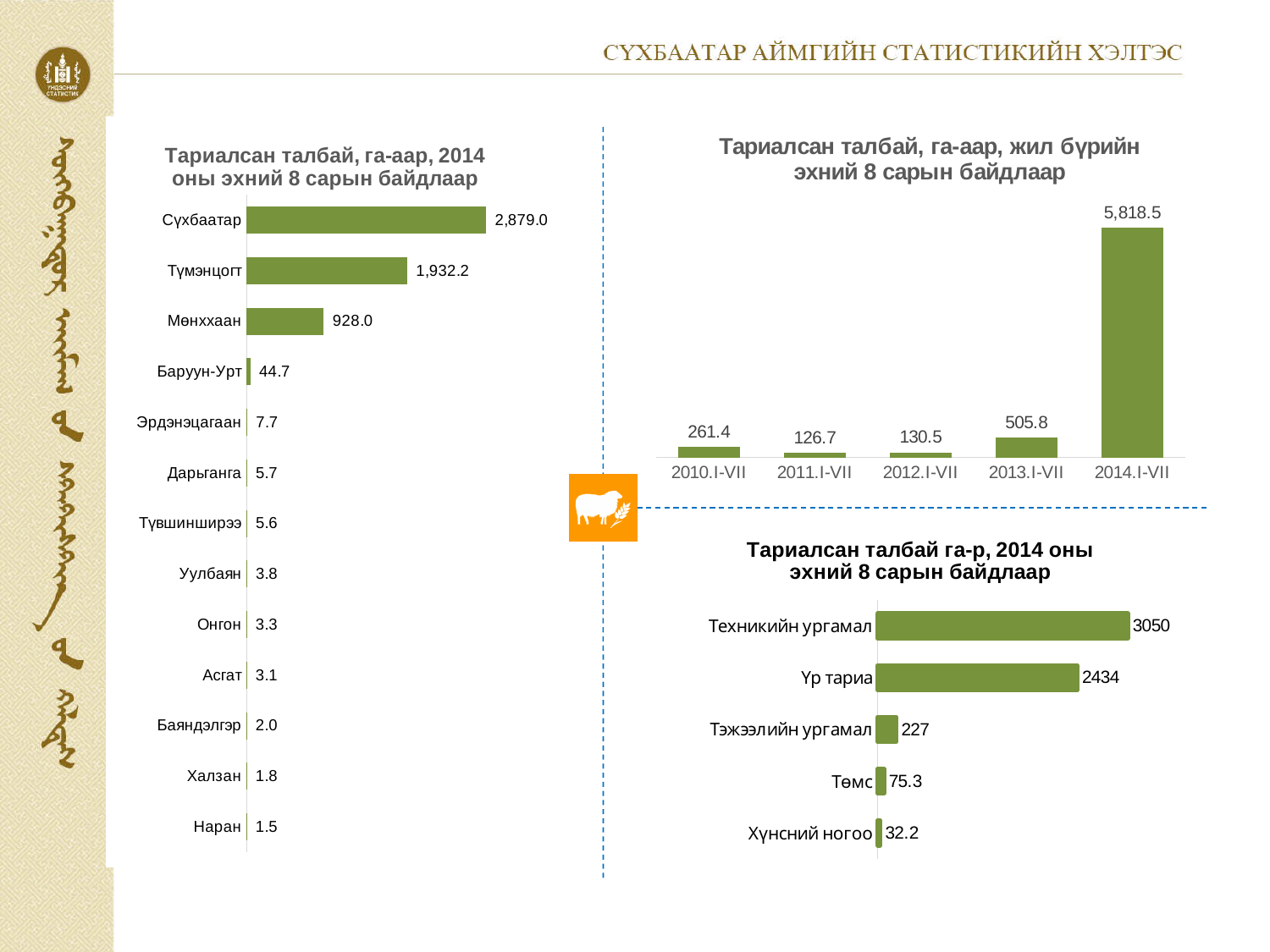
In the bottom right chart (Тариалсан талбай га-р, 2014 оны эхний 8 сарын байдлаар), how many categories are shown? 5 What kind of chart is the top right chart (Тариалсан талбай, га-аар, жил бүрийн эхний 8 сарын байдлаар)? Bar chart In the bottom right chart (Тариалсан талбай га-р, 2014 оны эхний 8 сарын байдлаар), what is the value for Тэжээлийн ургамал? 227 In the left chart (Тариалсан талбай, га-аар, 2014 оны эхний 8 сарын байдлаар), which category has the highest value? Сүхбаатар In the left chart (Тариалсан талбай, га-аар, 2014 оны эхний 8 сарын байдлаар), which category has the lowest value? Наран In the top right chart (Тариалсан талбай, га-аар, жил бүрийн эхний 8 сарын байдлаар), what is the value for 2013.I-VII? 505.8 In the top right chart (Тариалсан талбай, га-аар, жил бүрийн эхний 8 сарын байдлаар), which year has the lowest value? 2011.I-VII In the top right chart (Тариалсан талбай, га-аар, жил бүрийн эхний 8 сарын байдлаар), what is the difference between 2014.I-VII and 2013.I-VII? 5,312.7 In the left chart (Тариалсан талбай, га-аар, 2014 оны эхний 8 сарын байдлаар), how many categories are shown? 13 In the left chart (Тариалсан талбай, га-аар, 2014 оны эхний 8 сарын байдлаар), what is the difference between Сүхбаатар and Мөнххаан? 1,951.0 In the bottom right chart (Тариалсан талбай га-р, 2014 оны эхний 8 сарын байдлаар), which is larger: Үр тариа or Техникийн ургамал? Техникийн ургамал In the left chart (Тариалсан талбай, га-аар, 2014 оны эхний 8 сарын байдлаар), what is the value for Түмэнцогт? 1,932.2